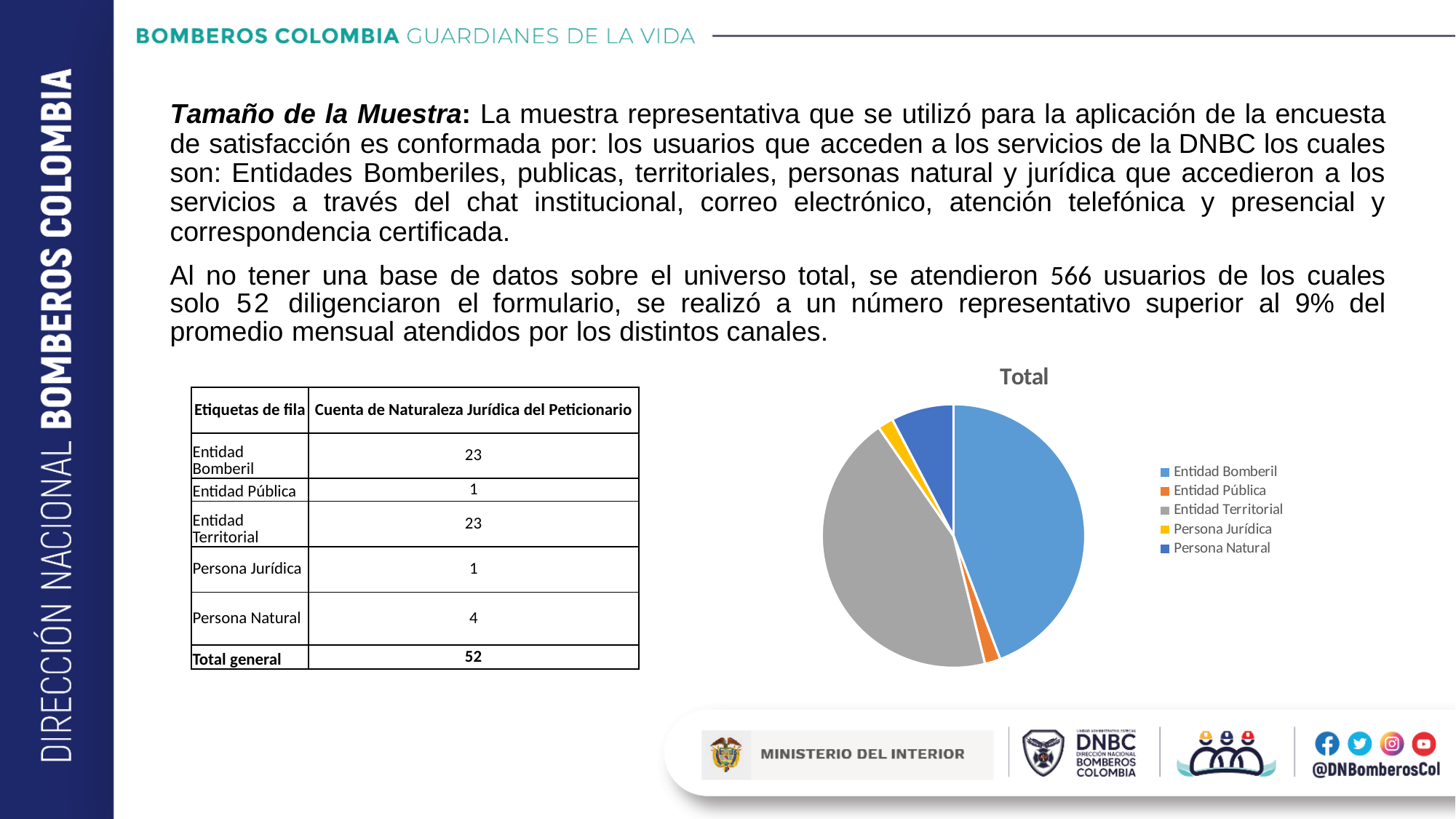
How many slices does the pie chart have? 5 What is the difference between the counts for Entidad Territorial and Persona Natural shown on the slide? 19 According to the table on the slide, what is the count for Entidad Bomberil shown in the pie chart? 23 What kind of chart is shown on the slide? pie chart According to the table on the slide, what is the count for Entidad Pública shown in the pie chart? 1 Which slice of the pie chart is larger, Persona Natural or Persona Jurídica? Persona Natural How many entries does the legend of the pie chart list? 5 Which slice of the pie chart is larger, Entidad Bomberil or Persona Natural? Entidad Bomberil According to the table on the slide, what is the count for Persona Natural shown in the pie chart? 4 What colour is the Entidad Territorial slice in the pie chart? grey What is the title of the pie chart? Total Which slice of the pie chart is larger, Entidad Territorial or Entidad Pública? Entidad Territorial